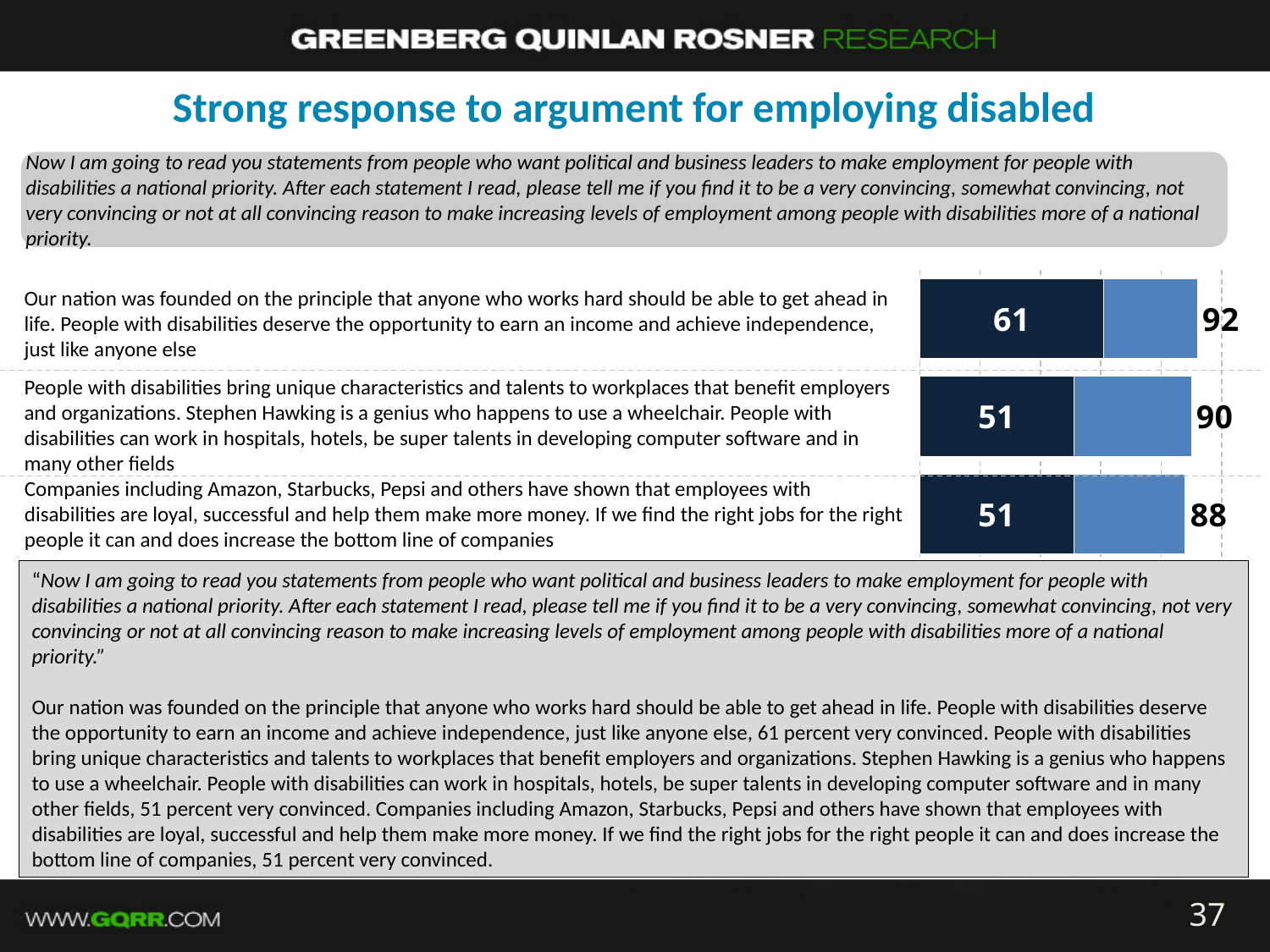
How many statements are plotted as bars in the chart? 3 What is the difference between the total value for the "Our nation was founded" statement and the total value for the Amazon, Starbucks, Pepsi statement? 4 For the "Our nation was founded" statement, what is the difference between the total value at the end of the bar and the value in the dark blue segment? 31 Which statement has the highest total value printed at the end of its bar? Our nation was founded on the principle that anyone who works hard should be able to get ahead in life What value is printed in the dark blue segment of the bar for the statement beginning "Our nation was founded on the principle that anyone who works hard should be able to get ahead in life"? 61 What value is printed in the dark blue segment of the bar for the statement about companies including Amazon, Starbucks and Pepsi? 51 Which statement has the lowest total value printed at the end of its bar? Companies including Amazon, Starbucks, Pepsi and others have shown that employees with disabilities are loyal, successful and help them make more money Which has the larger total value: the bar for the "Our nation was founded" statement or the bar for the Stephen Hawking statement? Our nation was founded on the principle that anyone who works hard should be able to get ahead in life What kind of chart is shown on the slide? Bar chart What is the difference between the dark blue segment value for the "Our nation was founded" statement and the dark blue segment value for the Stephen Hawking statement? 10 What total value is printed at the end of the bar for the statement about Stephen Hawking and people with disabilities bringing unique characteristics and talents to workplaces? 90 What total value is printed at the end of the bar for the statement about companies including Amazon, Starbucks and Pepsi? 88